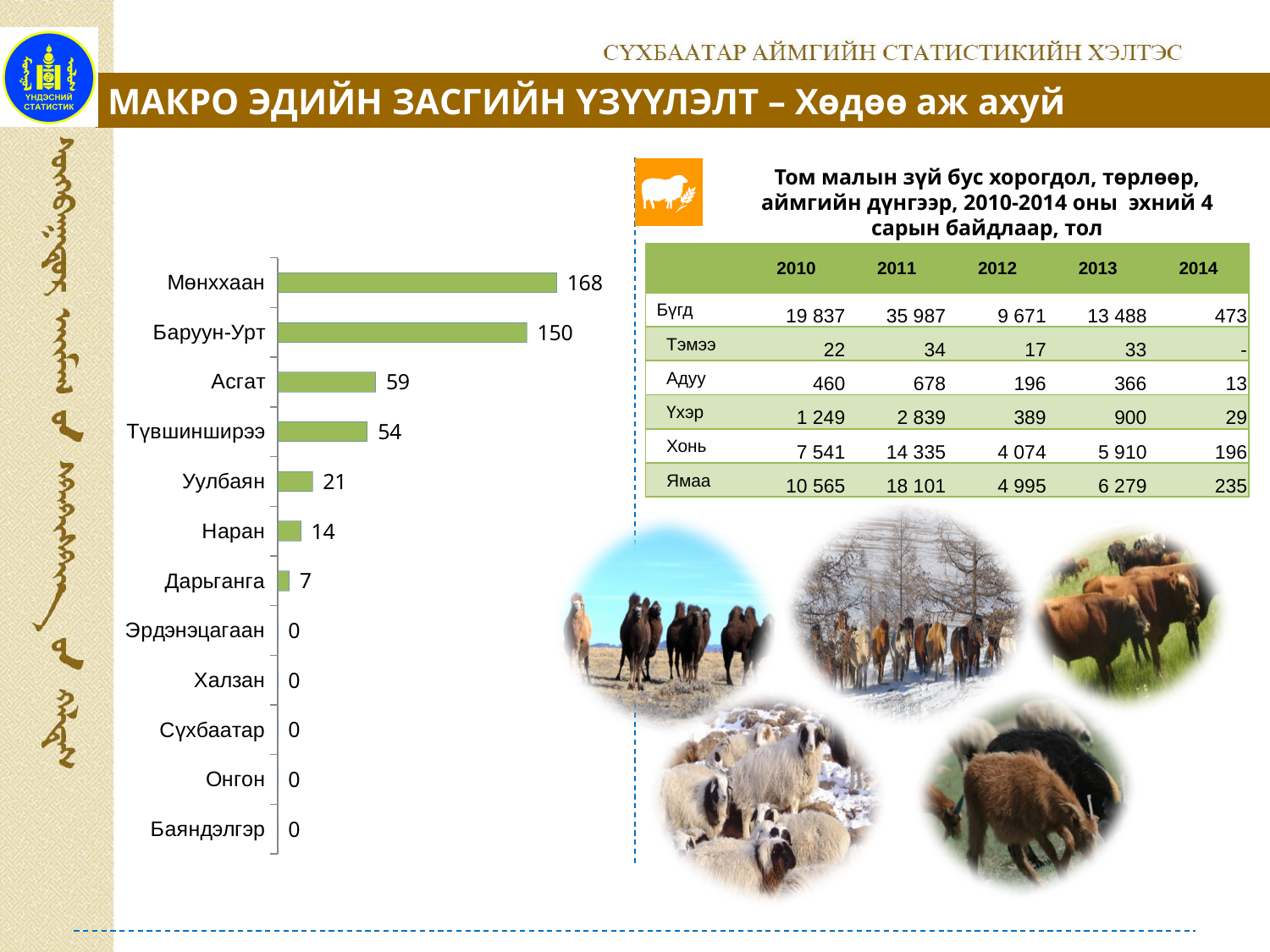
In the bar chart, what is the value for Баруун-Урт? 150 In the bar chart, what is the value for Наран? 14 Which category has the highest value in the bar chart? Мөнххаан In the bar chart, which is larger, the value for Асгат or the value for Түвшинширээ? Асгат In the bar chart, what is the value for Түвшинширээ? 54 How many categories in the bar chart have a value of 0? 5 In the bar chart, what is the value for Дарьганга? 7 What type of chart is shown on the left side of the slide? bar chart How many categories are shown in the bar chart? 12 In the bar chart, what is the value for Мөнххаан? 168 In the bar chart, what is the difference between the values for Уулбаян and Наран? 7 In the bar chart, what is the difference between the values for Мөнххаан and Баруун-Урт? 18